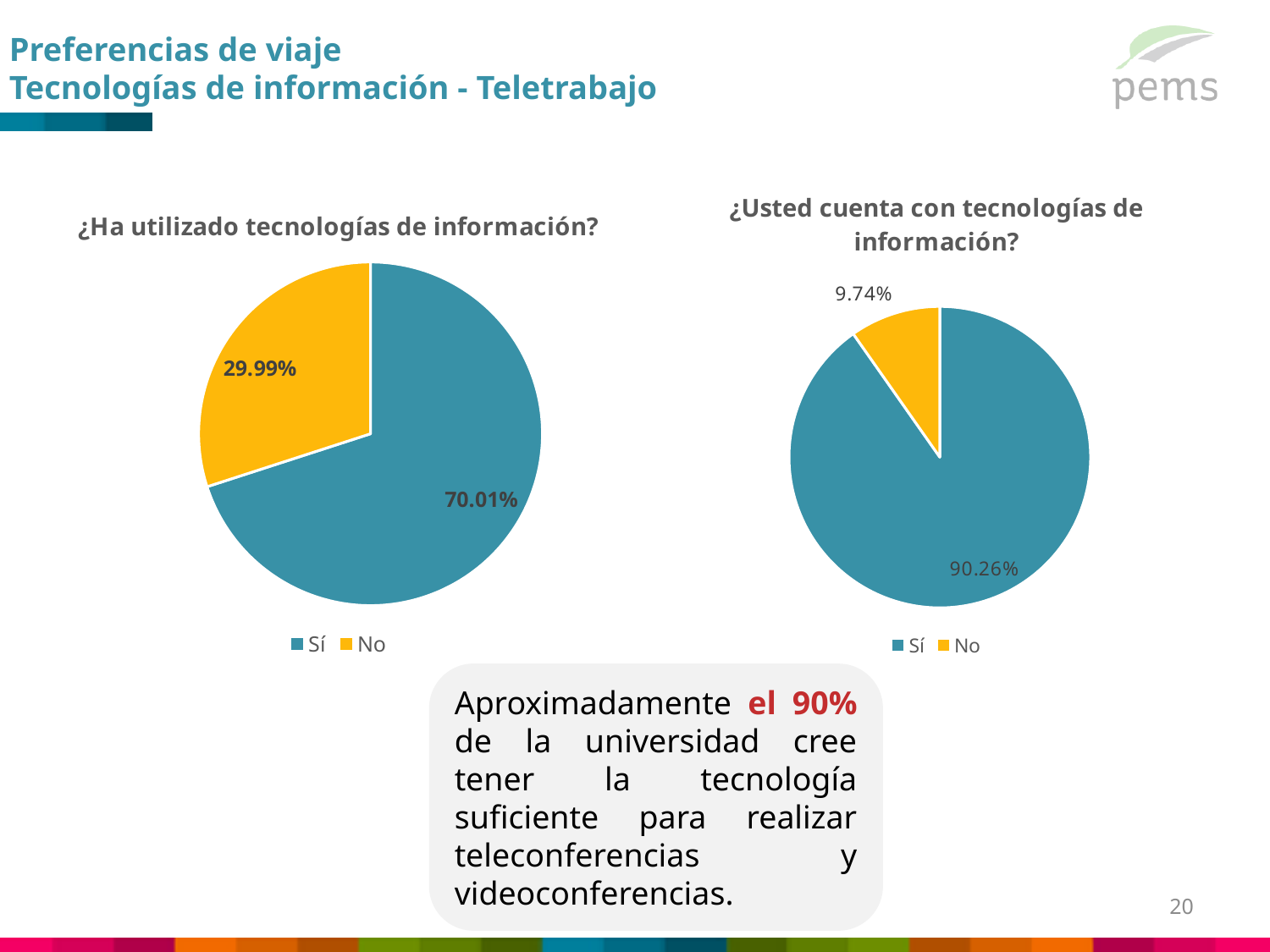
In the chart titled "¿Ha utilizado tecnologías de información?", what colour is the No slice? Yellow In the chart titled "¿Ha utilizado tecnologías de información?", what is the difference between the Sí and No percentages? 40.02% Which chart has the larger Sí share: "¿Ha utilizado tecnologías de información?" or "¿Usted cuenta con tecnologías de información?"? ¿Usted cuenta con tecnologías de información? How many categories does the legend of the chart titled "¿Usted cuenta con tecnologías de información?" list? 2 In the chart titled "¿Usted cuenta con tecnologías de información?", which category has the smallest slice? No In the chart titled "¿Ha utilizado tecnologías de información?", what percentage answered Sí? 70.01% In the chart titled "¿Usted cuenta con tecnologías de información?", what percentage answered Sí? 90.26% In the chart titled "¿Ha utilizado tecnologías de información?", which category has the largest slice? Sí In the chart titled "¿Ha utilizado tecnologías de información?", what percentage answered No? 29.99% In the chart titled "¿Usted cuenta con tecnologías de información?", what is the difference between the Sí and No percentages? 80.52% In the chart titled "¿Usted cuenta con tecnologías de información?", what percentage answered No? 9.74% What type of chart is used for "¿Ha utilizado tecnologías de información?"? Pie chart